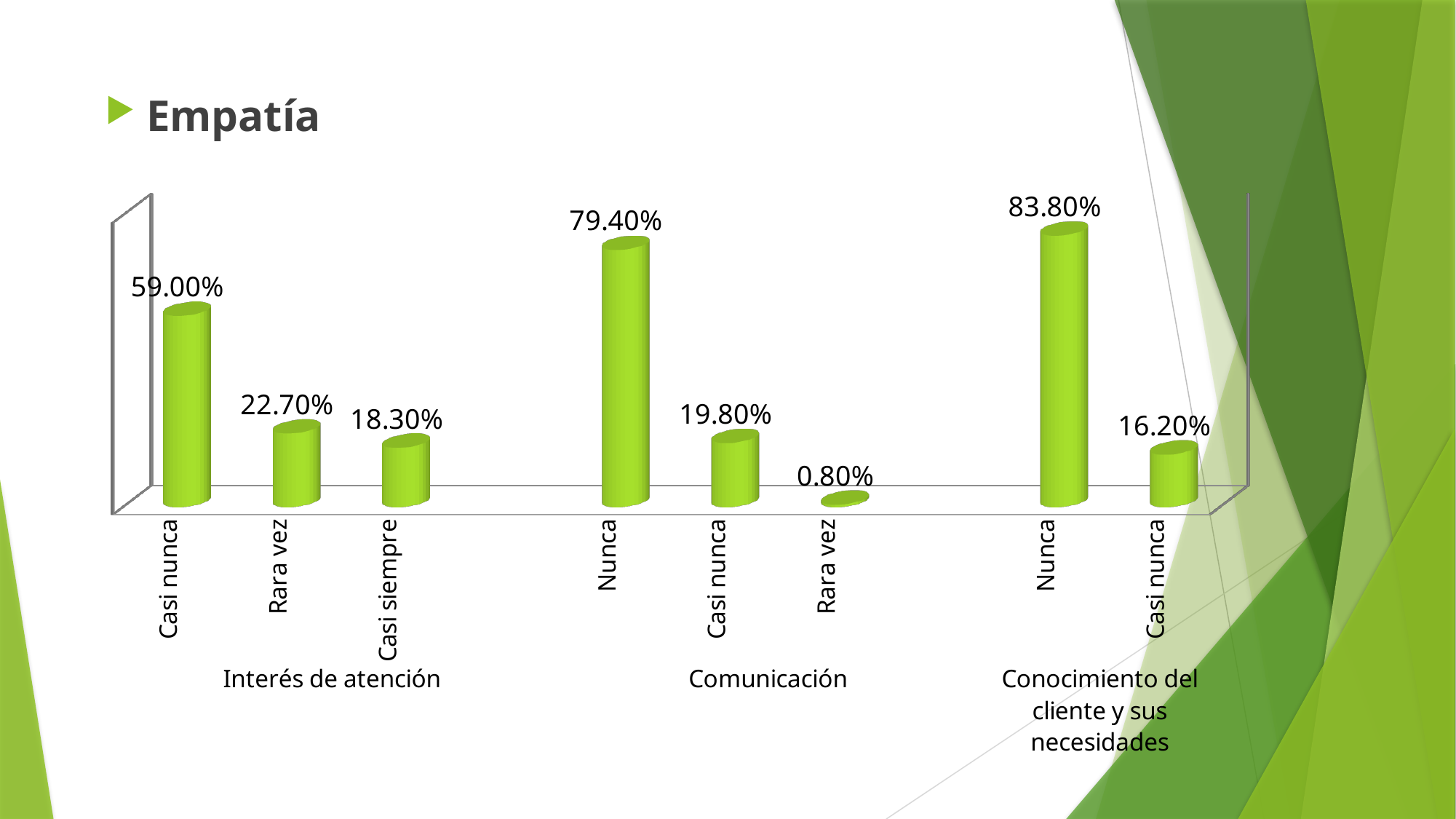
What kind of chart is shown on the slide? Bar chart What is the value for "Casi nunca" under "Interés de atención"? 59.00% Which bar has the highest value in the chart? Nunca (Conocimiento del cliente y sus necesidades), 83.80% How many bars are plotted in the chart? 8 What is the difference between "Rara vez" and "Casi siempre" under "Interés de atención"? 4.40% How many category groups are shown along the x axis? 3 What is the value for "Casi nunca" under "Conocimiento del cliente y sus necesidades"? 16.20% Which bar has the lowest value in the chart? Rara vez (Comunicación), 0.80% What is the title of the slide? Empatía What is the value for "Rara vez" under "Comunicación"? 0.80% What is the value for "Nunca" under "Comunicación"? 79.40% Which is larger: "Nunca" under "Comunicación" or "Nunca" under "Conocimiento del cliente y sus necesidades"? Nunca under Conocimiento del cliente y sus necesidades